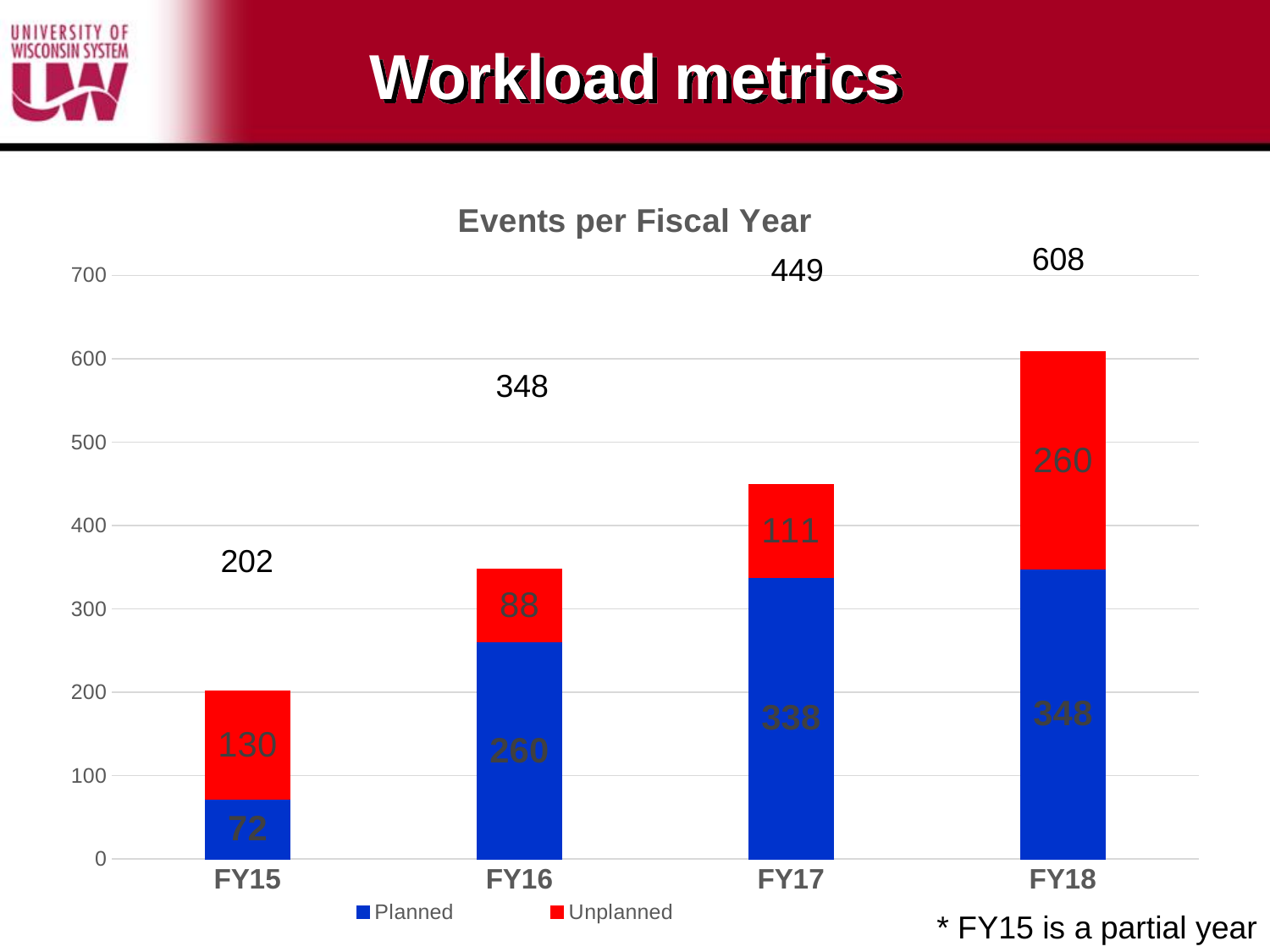
Which is larger, the Unplanned value for FY17 or the Unplanned value for FY18? FY18 Which fiscal year has the highest Planned value? FY18 What is the total number of events for FY16? 348 How many series does the legend list? 2 What kind of chart is shown? Stacked bar chart What is the total number of events for FY18? 608 Do the total events per fiscal year rise or fall from FY15 to FY18? Rise What is the Unplanned value for FY15? 130 Which fiscal year has the lowest Unplanned value? FY16 How many fiscal years are shown on the x axis? 4 What is the Planned value for FY17? 338 What is the difference between the Planned values for FY18 and FY15? 276